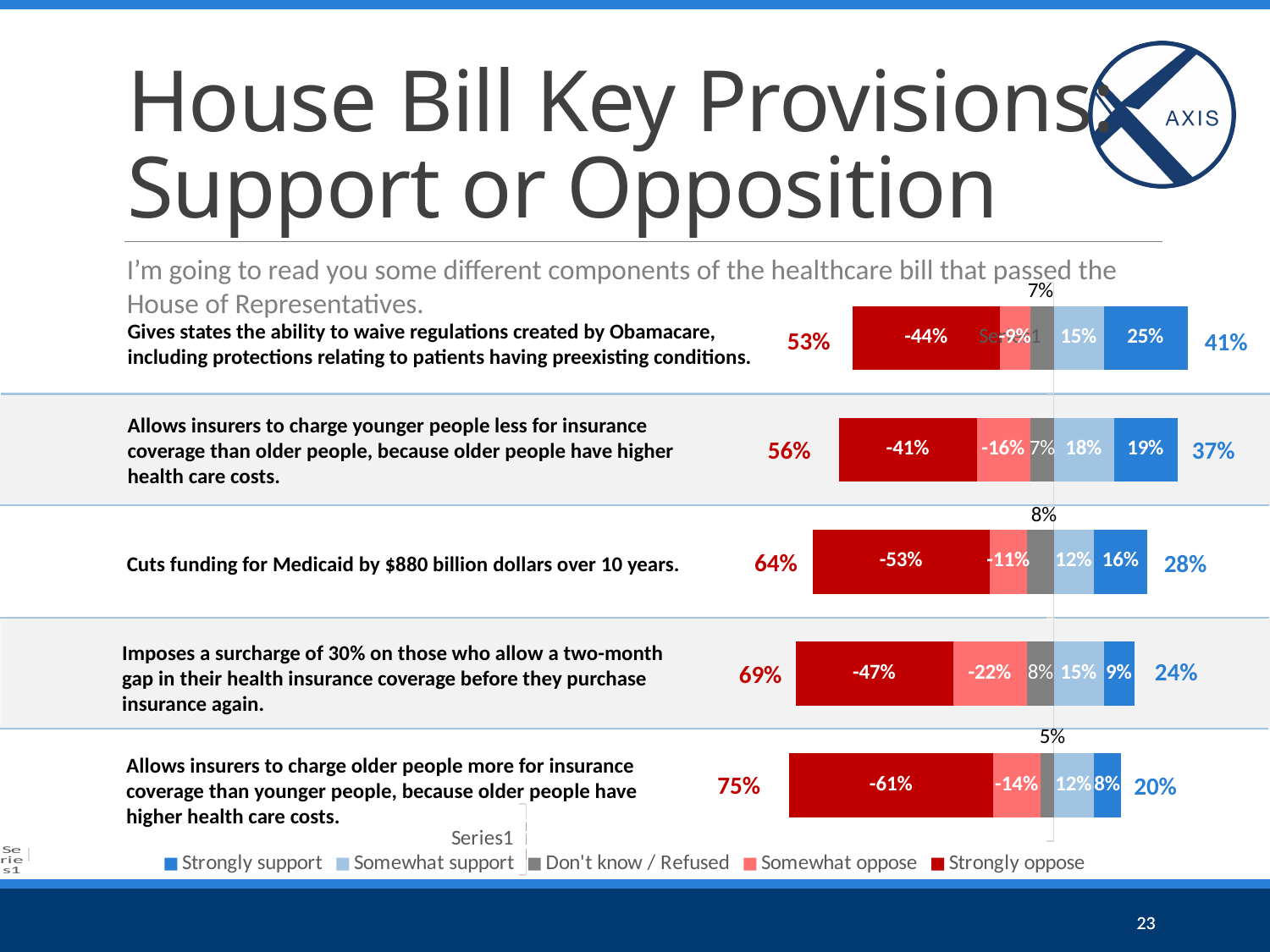
How many provisions are shown in the chart? 5 What is the Strongly oppose value for the provision that allows insurers to charge older people more for insurance coverage than younger people? -61% Which has a larger Strongly support value: the provision giving states the ability to waive Obamacare regulations or the provision imposing a 30% surcharge for a coverage gap? Gives states the ability to waive regulations created by Obamacare Which provision has the highest total opposition percentage? Allows insurers to charge older people more for insurance coverage than younger people, because older people have higher health care costs. Which provision has the lowest total support percentage? Allows insurers to charge older people more for insurance coverage than younger people, because older people have higher health care costs. What is the Somewhat oppose value for the provision that imposes a surcharge of 30% on those who allow a two-month gap in coverage? -22% What is the total opposition percentage shown for the provision that cuts funding for Medicaid by $880 billion dollars over 10 years? 64% What is the difference between the total support for the provision giving states the ability to waive Obamacare regulations (41%) and the total support for the Medicaid funding cut (28%)? 13 percentage points What is the total support percentage shown for the provision that gives states the ability to waive regulations created by Obamacare? 41% What is the Strongly support value for the provision that allows insurers to charge younger people less for insurance coverage than older people? 19% What kind of chart is shown on the slide? Stacked bar chart How many series does the legend list? 5